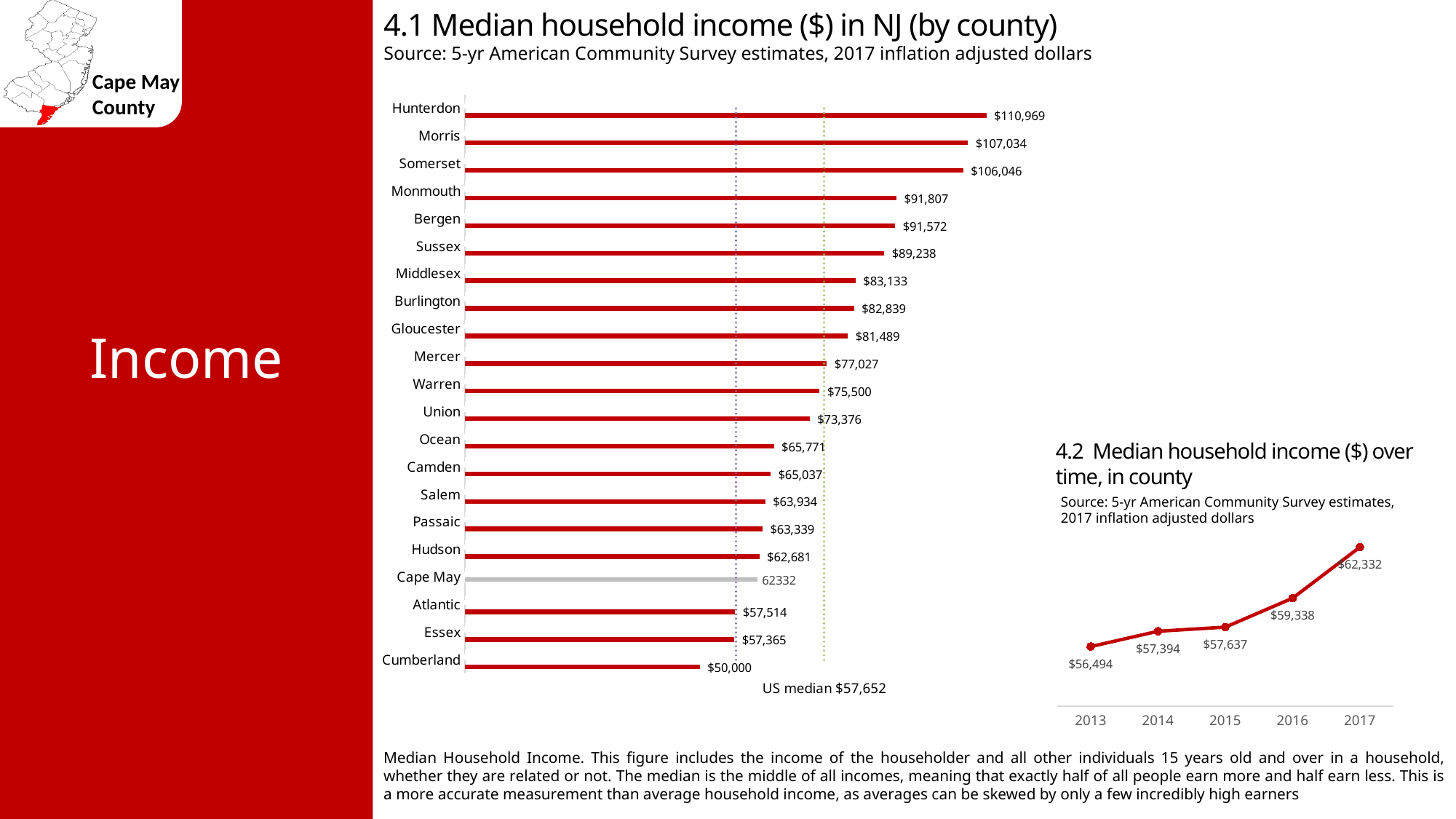
What kind of chart is chart 4.1 (Median household income in NJ by county)? Bar chart In chart 4.2 (Median household income over time, in county), does the median household income rise or fall from 2013 to 2017? Rise In chart 4.1 (Median household income in NJ by county), what value is labeled for Cape May? 62332 In chart 4.2 (Median household income over time, in county), what is the median household income in 2017? $62,332 In chart 4.2 (Median household income over time, in county), what is the difference between the 2017 and 2013 values? $5,838 In chart 4.1 (Median household income in NJ by county), what is the median household income for Hunterdon? $110,969 In chart 4.1 (Median household income in NJ by county), which county has the highest median household income? Hunterdon In chart 4.1 (Median household income in NJ by county), which has a higher median household income, Monmouth or Sussex? Monmouth In chart 4.1 (Median household income in NJ by county), what is the median household income for Cumberland? $50,000 In chart 4.1 (Median household income in NJ by county), what is the difference between Hunterdon's and Cumberland's median household income? $60,969 In chart 4.1 (Median household income in NJ by county), how many counties are shown? 21 In chart 4.1 (Median household income in NJ by county), which county has the lowest median household income? Cumberland